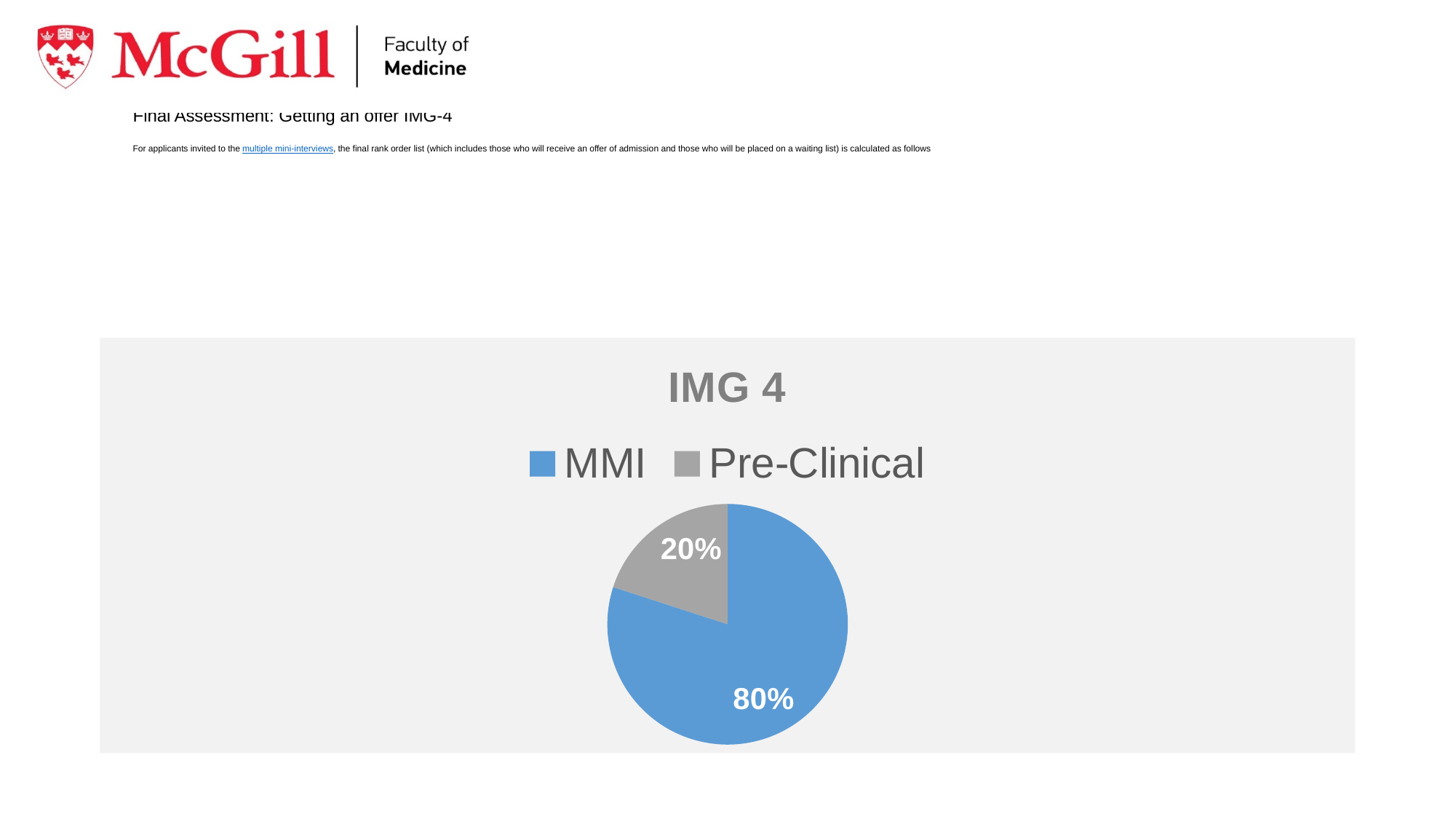
What share of the pie does MMI represent? 80% Which slice of the pie is the smallest? Pre-Clinical Is the value for MMI greater or less than 50%? greater What is the difference in percentage points between the MMI and Pre-Clinical slices? 60 What is the title of the chart? IMG 4 Which colour represents Pre-Clinical in the chart? grey How many slices does the pie chart have? 2 What share of the pie does Pre-Clinical represent? 20% What type of chart is shown on the slide? pie chart How many entries does the legend list? 2 Which is larger, the MMI slice or the Pre-Clinical slice? MMI Which slice of the pie is the largest? MMI